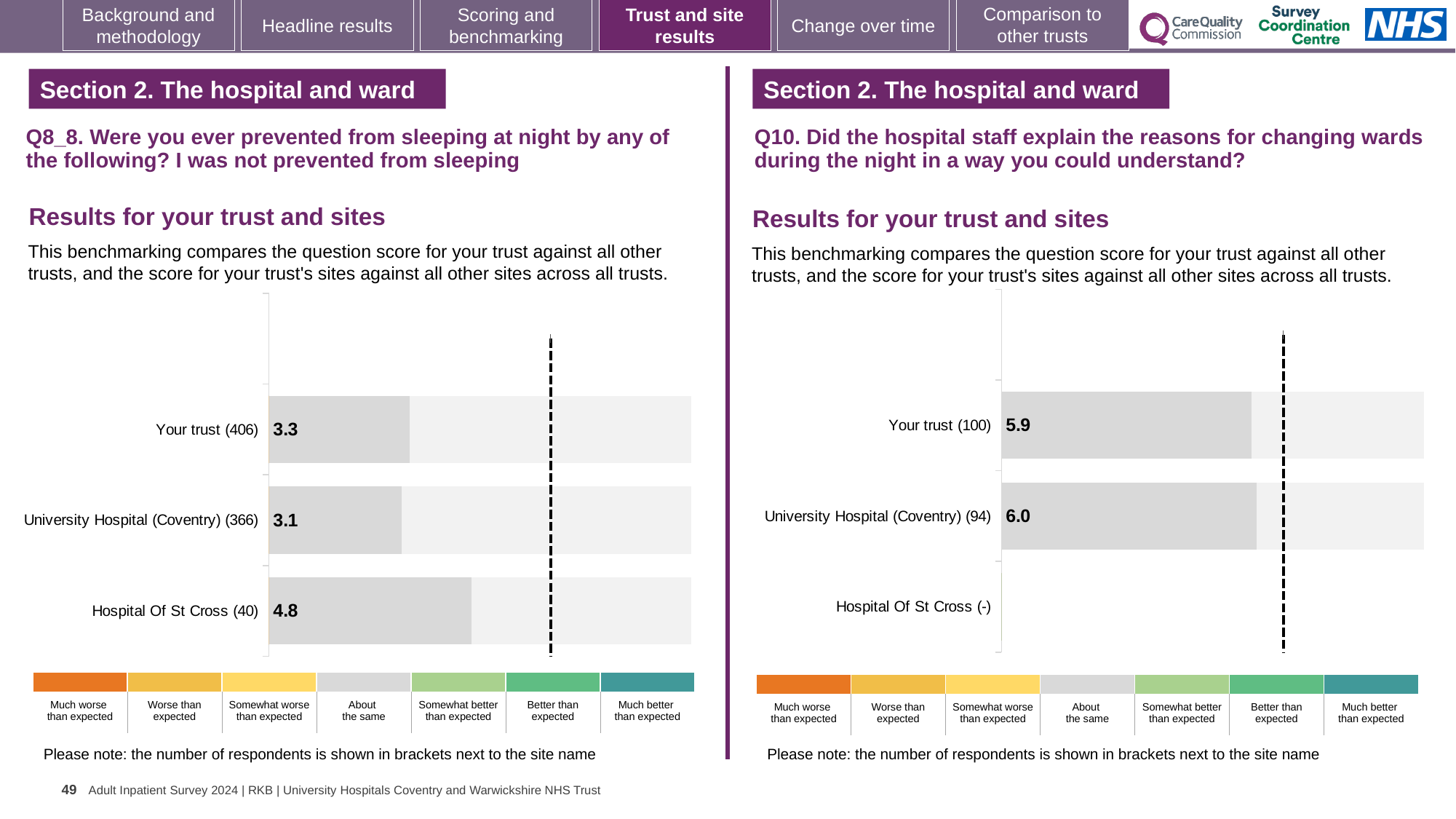
On the left chart (Q8_8), how many respondents are shown for Hospital Of St Cross? 40 On the left chart (Q8_8), what is the score for University Hospital (Coventry)? 3.1 On the right chart (Q10), how many categories are listed on the vertical axis? 3 On the left chart (Q8_8), what is the difference between the scores for Hospital Of St Cross and Your trust? 1.5 On the right chart (Q10), what is the score for University Hospital (Coventry)? 6.0 On the left chart (Q8_8), what is the score for Hospital Of St Cross? 4.8 On the left chart (Q8_8), which site or trust has the lowest score? University Hospital (Coventry) On the right chart (Q10), what is the score for Your trust? 5.9 What kind of chart is shown on the left (Q8_8)? Bar chart On the right chart (Q10), how many respondents are shown for Your trust? 100 On the left chart (Q8_8), which site or trust has the highest score? Hospital Of St Cross On the left chart (Q8_8), what is the score for Your trust? 3.3